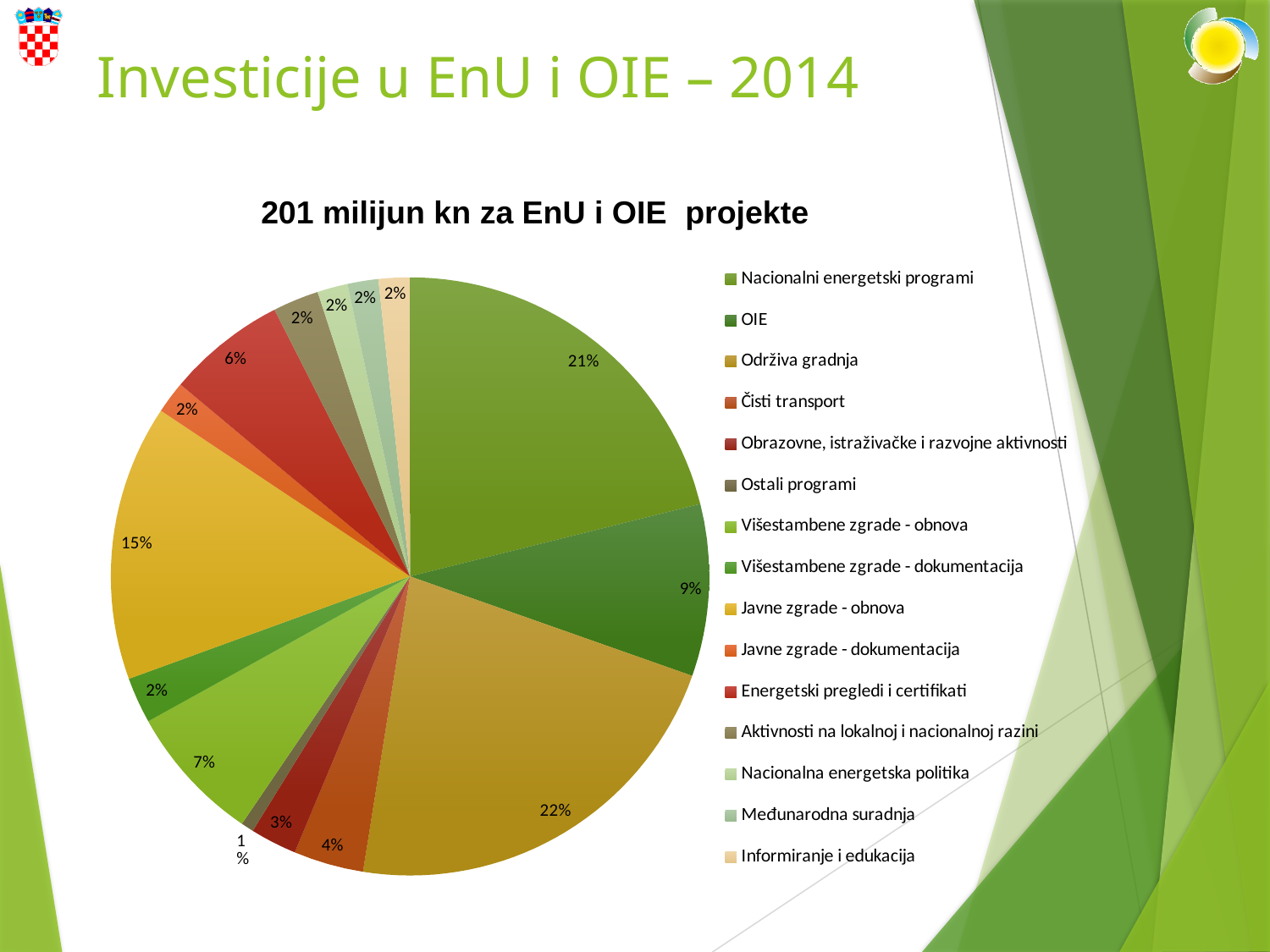
Which category has the smallest slice of the pie? Ostali programi What share of the pie does Održiva gradnja have? 22% How many categories does the legend of the pie chart list? 15 Which category has the largest slice of the pie? Održiva gradnja What kind of chart is shown on the slide? pie chart Which is larger, the share for Višestambene zgrade - obnova or the share for Energetski pregledi i certifikati? Višestambene zgrade - obnova What share of the pie does OIE have? 9% What share of the pie does Javne zgrade - obnova have? 15% What is the title of the chart? 201 milijun kn za EnU i OIE projekte What is the difference in percentage points between Održiva gradnja and Javne zgrade - obnova? 7